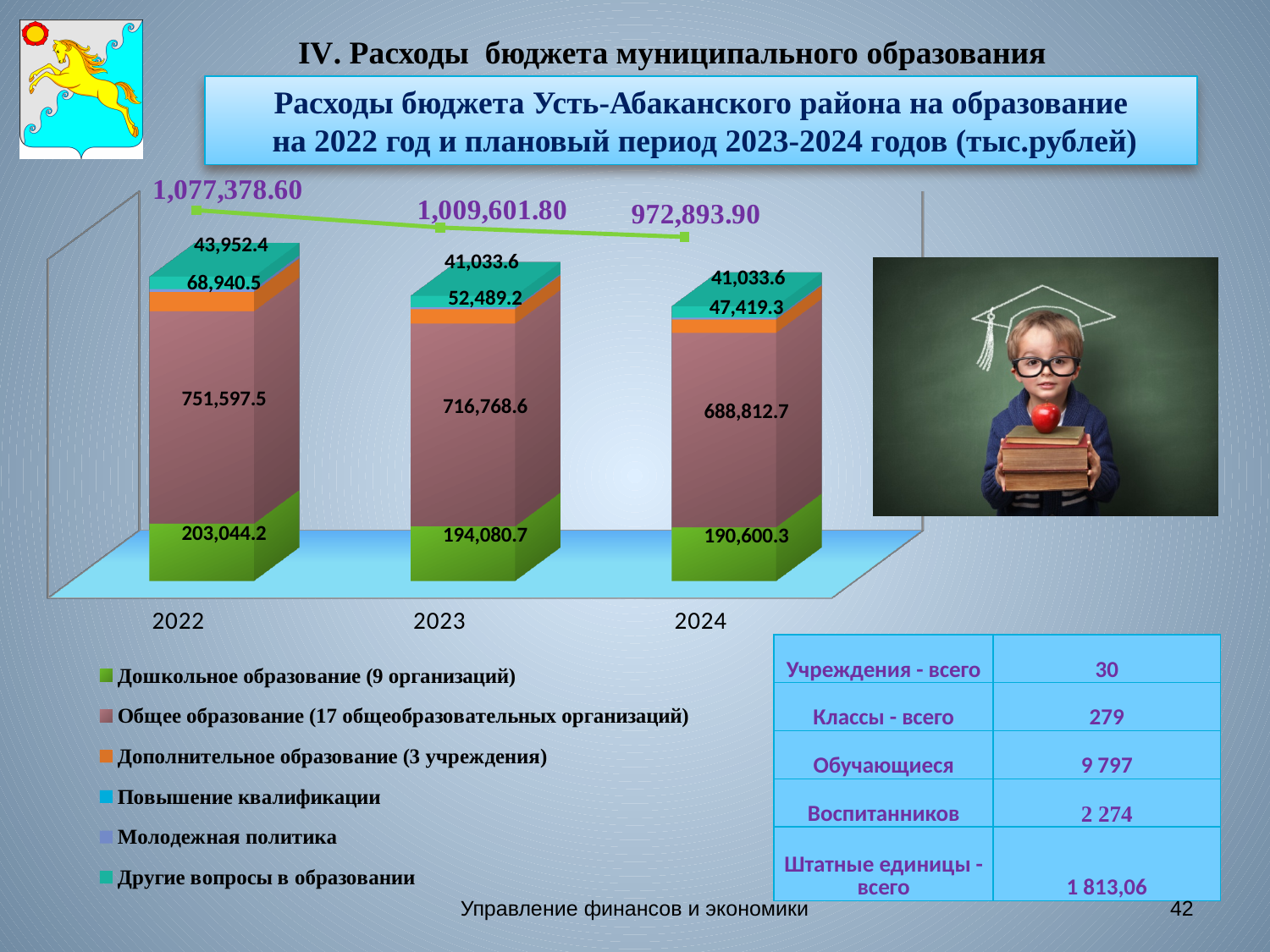
Which year has the larger value for Дополнительное образование, 2022 or 2023? 2022 What total value is shown on the line above the 2022 bar? 1,077,378.60 What kind of chart is shown on the slide? Stacked bar chart What total value is shown on the line above the 2024 bar? 972,893.90 How many series does the chart legend list? 6 Which year has the highest total education expenditure shown on the line? 2022 What is the value for Дошкольное образование in 2022? 203,044.2 How many years are shown on the x axis of the chart? 3 What is the value for Общее образование in 2024? 688,812.7 What is the difference between the Дошкольное образование values for 2022 and 2024? 12,443.9 What is the value for Дополнительное образование in 2023? 52,489.2 Which year has the lowest value for Общее образование? 2024